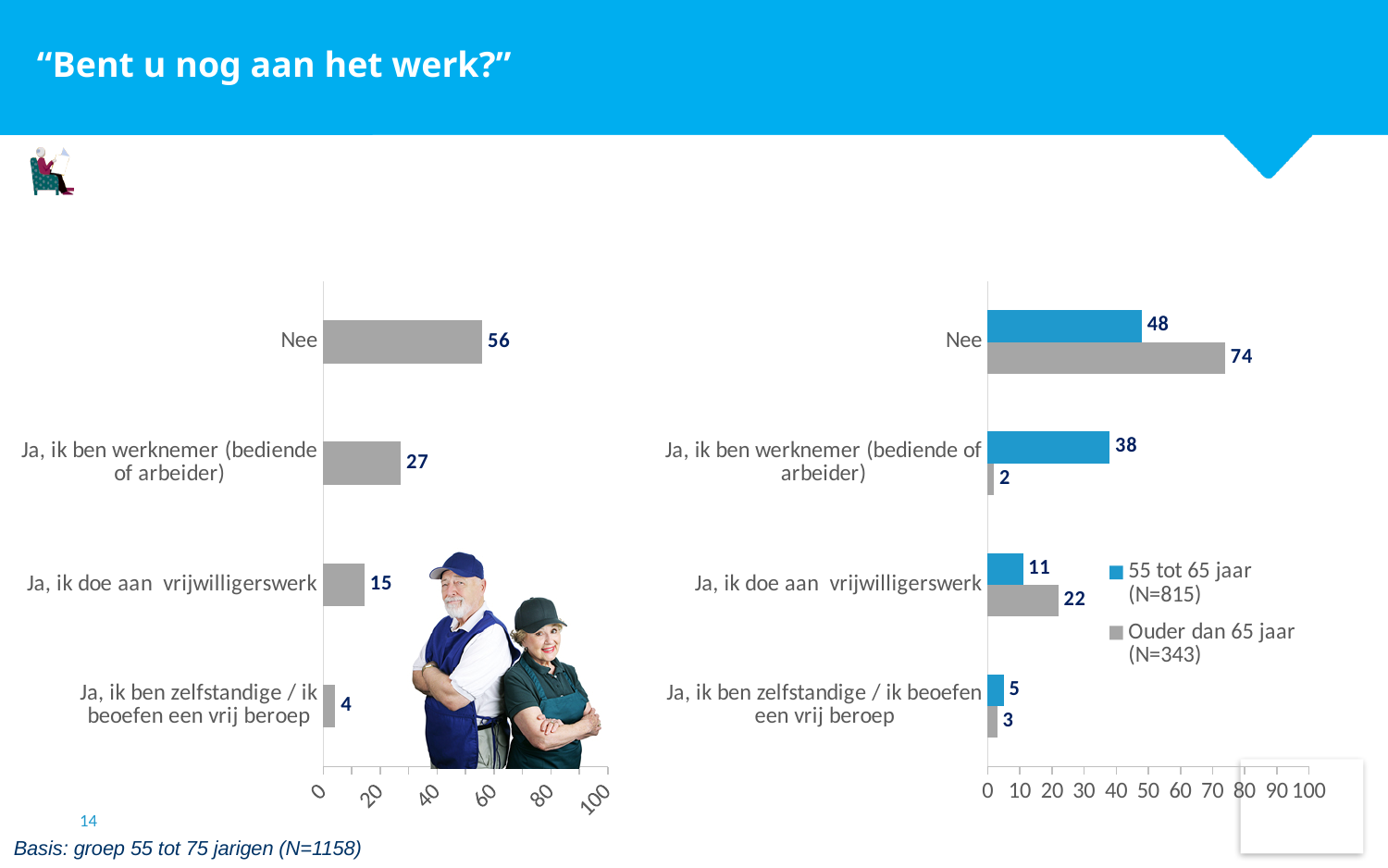
In the left chart, what is the value for "Nee"? 56 In the left chart, what is the difference between the values for "Nee" and "Ja, ik ben werknemer (bediende of arbeider)"? 29 In the right chart, which series has the larger value for "Ja, ik doe aan vrijwilligerswerk"? Ouder dan 65 jaar (N=343) How many series does the legend of the right chart list? 2 In the left chart, which category has the lowest value? Ja, ik ben zelfstandige / ik beoefen een vrij beroep In the left chart, what is the value for "Ja, ik doe aan vrijwilligerswerk"? 15 In the right chart, which colour represents the "55 tot 65 jaar (N=815)" series? Blue What kind of chart is the left chart? Bar chart In the right chart, what is the value for "Ja, ik ben werknemer (bediende of arbeider)" in the "55 tot 65 jaar (N=815)" series? 38 How many categories are shown in the right chart? 4 In the right chart, what is the value for "Nee" in the "Ouder dan 65 jaar (N=343)" series? 74 In the right chart, what is the difference between the two series for "Ja, ik ben werknemer (bediende of arbeider)"? 36